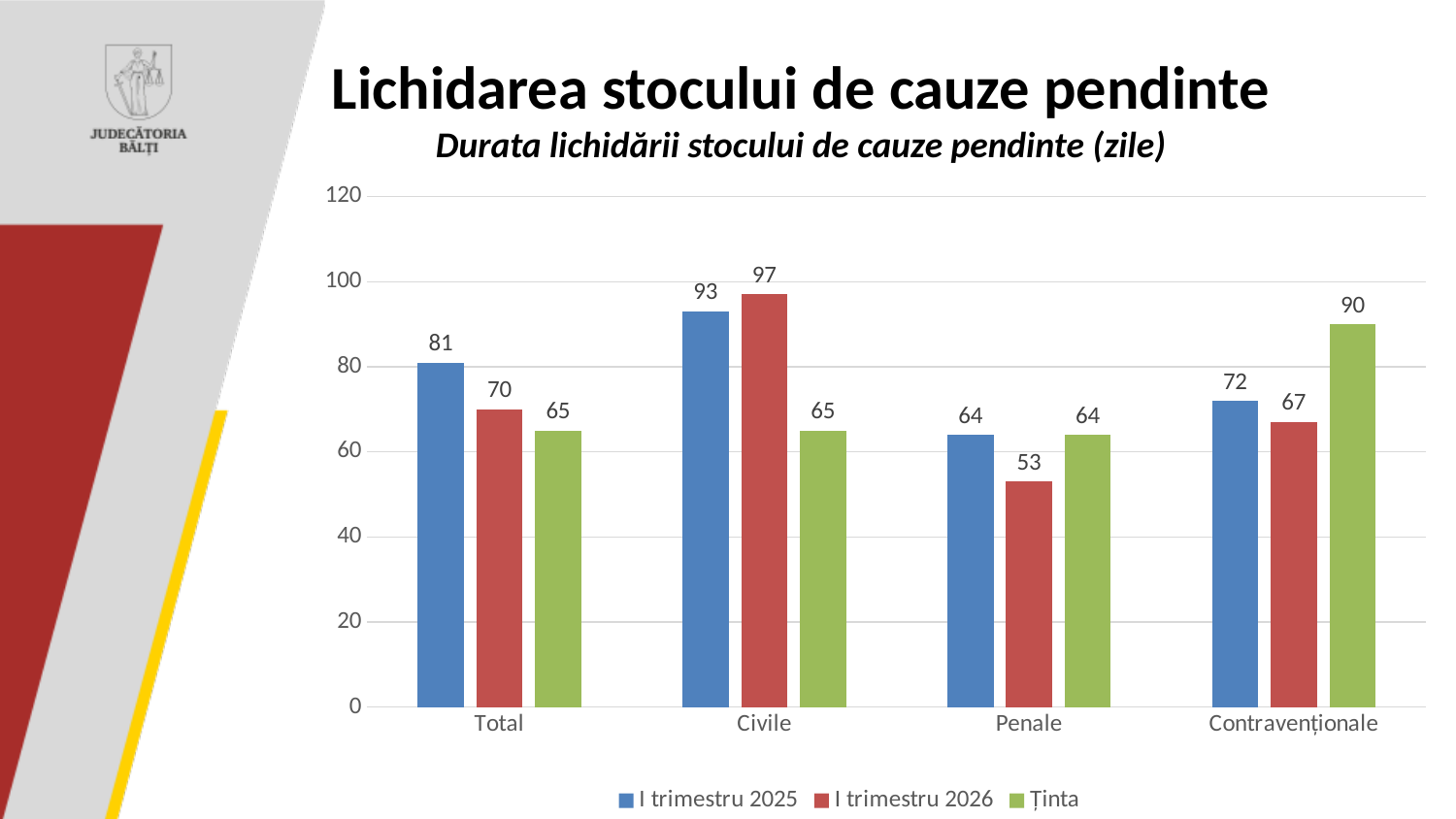
Which is larger for Contravenționale: the I trimestru 2026 value or the Ținta value? Ținta What is the difference between the I trimestru 2025 and I trimestru 2026 values for Total? 11 How many series does the legend list? 3 Which category has the lowest value in the I trimestru 2026 series? Penale Which category has the highest value in the I trimestru 2026 series? Civile What is the value for Civile in the I trimestru 2026 series? 97 What kind of chart is shown on the slide? bar chart What is the Ținta value for Contravenționale? 90 Is the I trimestru 2025 value for Civile greater or less than 80? greater What is the value for Penale in the I trimestru 2025 series? 64 How many categories are shown on the x axis? 4 What is the subtitle of the chart? Durata lichidării stocului de cauze pendinte (zile)